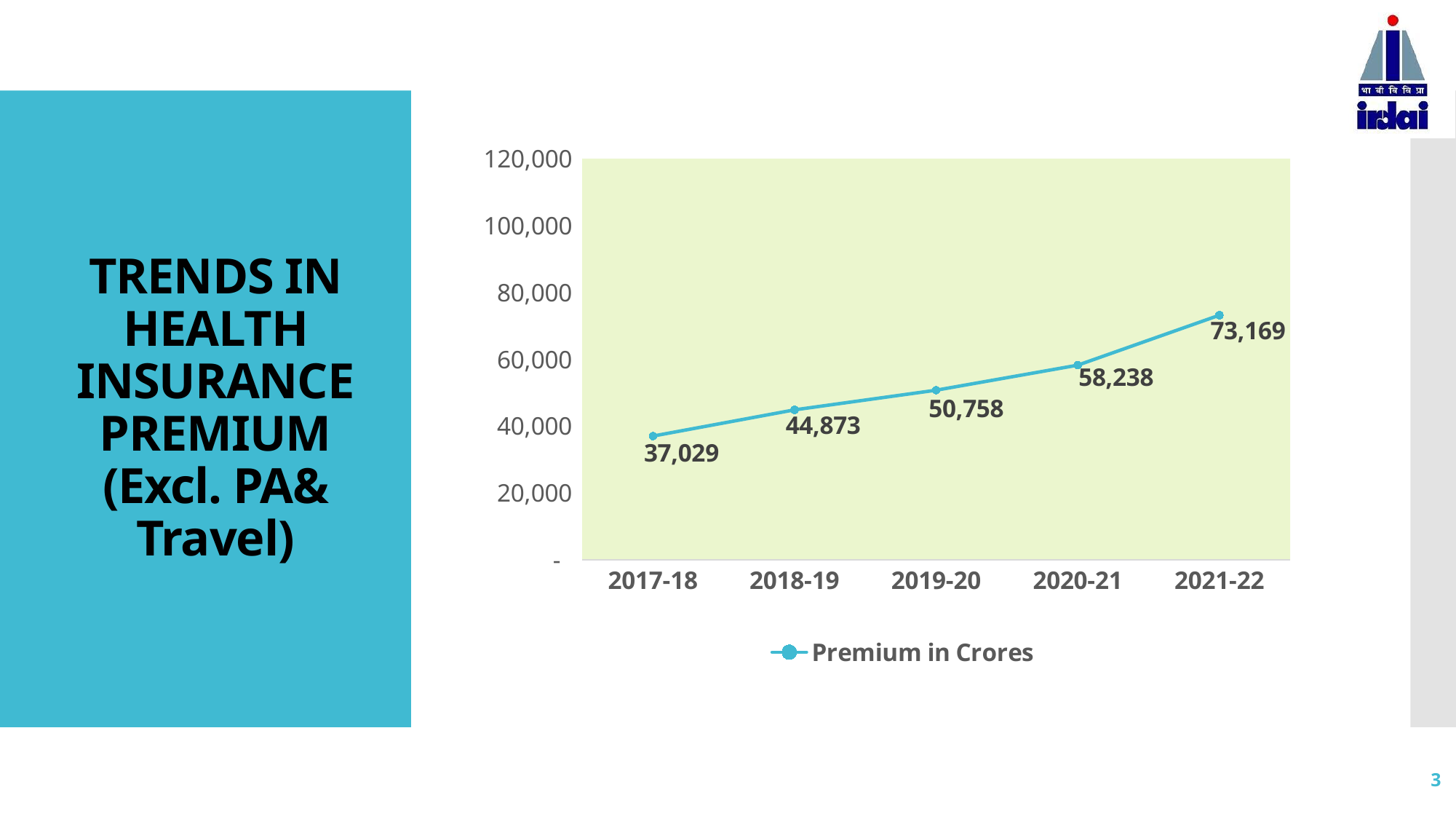
What is the difference between the premium in 2021-22 and 2020-21? 14,931 Does the premium rise or fall from 2017-18 to 2021-22? rise What is the premium in crores for 2019-20? 50,758 What kind of chart is shown on the slide? line chart What is the premium in crores for 2021-22? 73,169 Is the premium for 2020-21 greater or less than 60,000? less Which year has the highest premium? 2021-22 Which year has a larger premium, 2019-20 or 2020-21? 2020-21 What is the difference between the premium in 2018-19 and 2017-18? 7,844 What is the premium in crores for 2017-18? 37,029 How many years are plotted on the chart? 5 Which year has the lowest premium? 2017-18